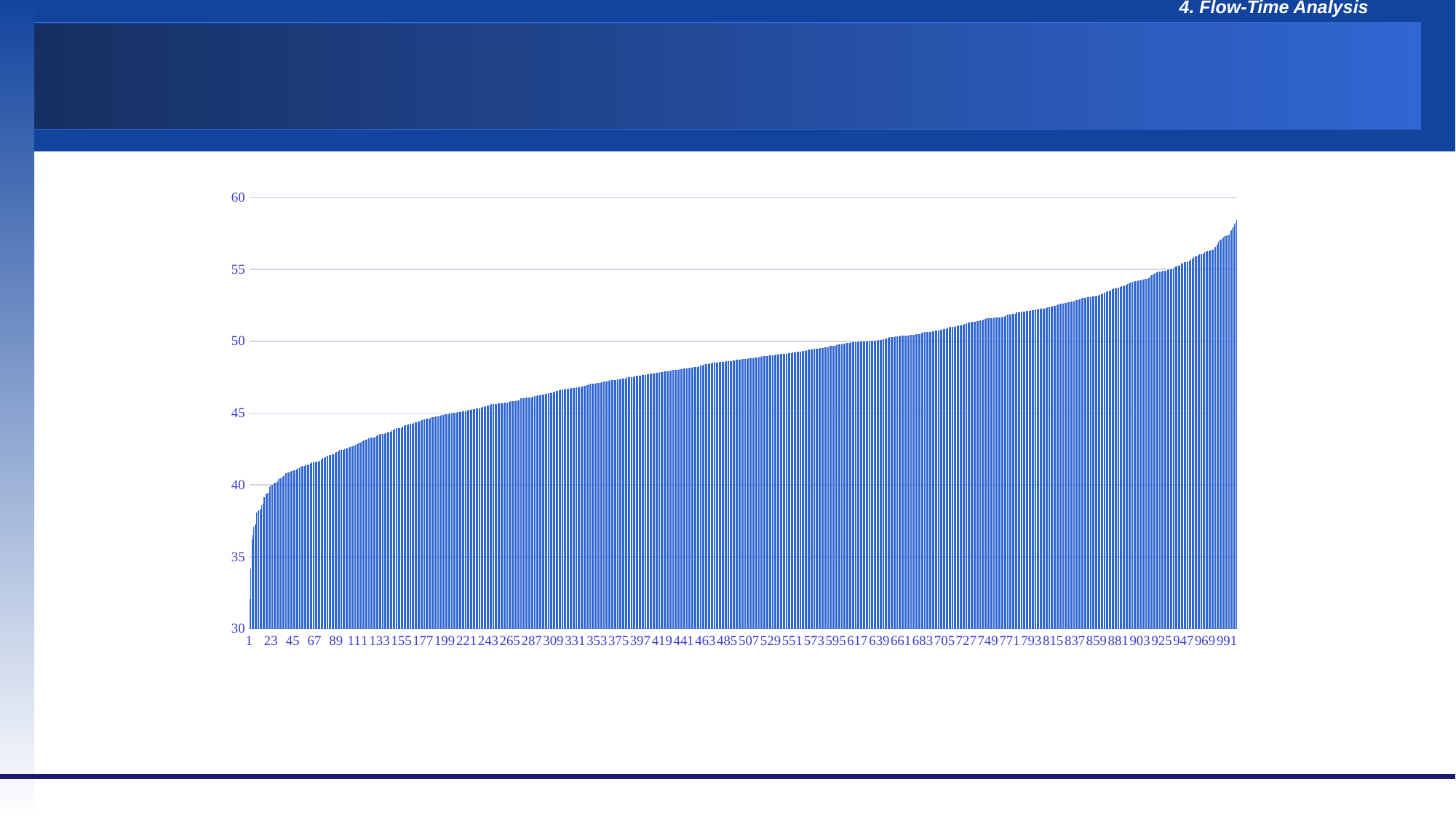
Is the value for category 749 greater or less than 50? greater Is the value for category 1 greater or less than 40? less Is the value for category 23 greater or less than 45? less Do the bar values rise or fall as you move from left to right along the x axis? rise Which has the larger value, category 1 or category 991? 991 What kind of chart is shown on the slide? bar chart What is the lowest value shown on the y axis? 30 What is the highest value shown on the y axis? 60 Which has the larger value, category 133 or category 859? 859